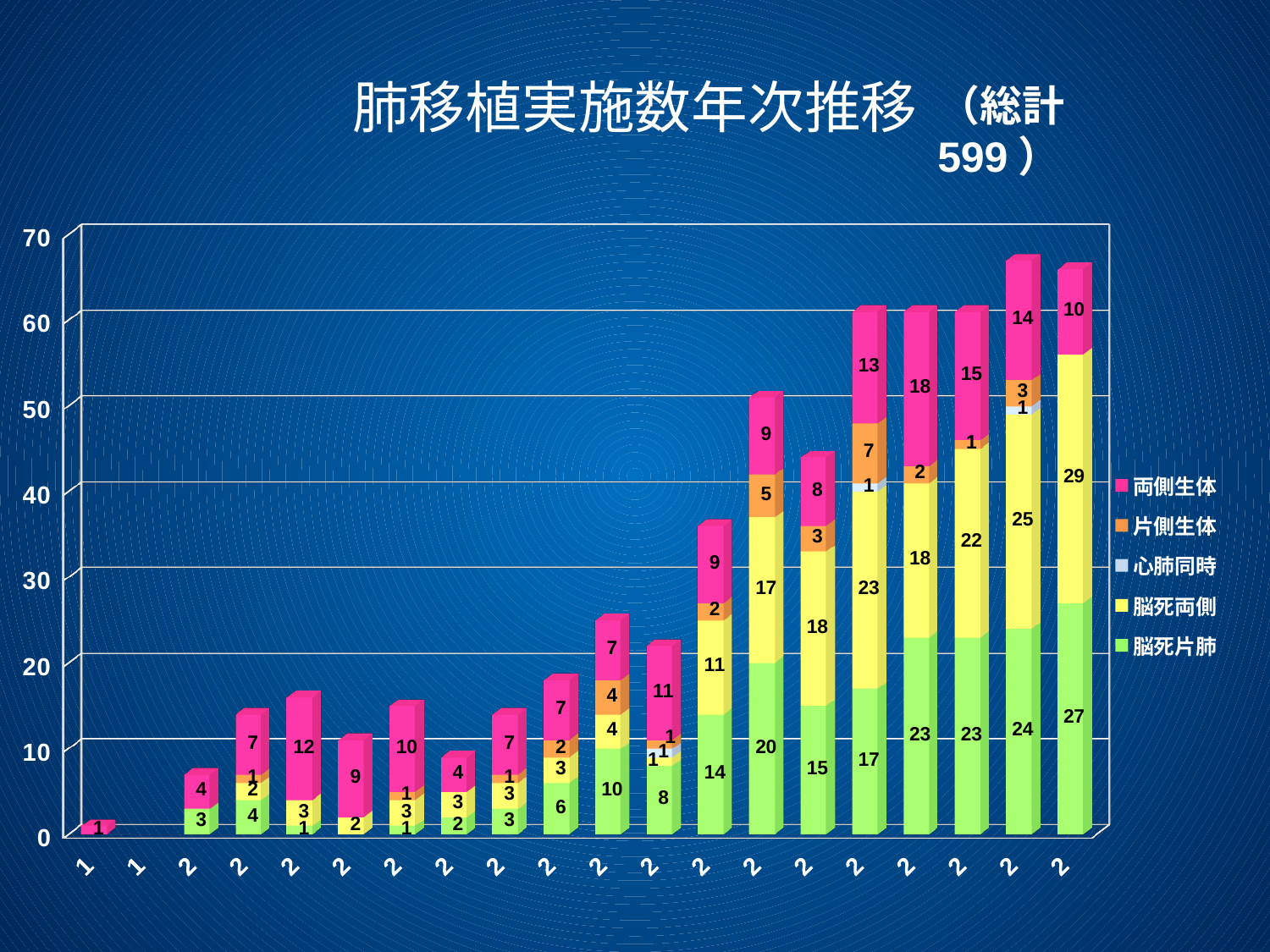
What is the 脳死両側 value in the rightmost bar? 29 In the rightmost bar, what is the difference between the 脳死両側 value and the 両側生体 value? 19 How many series does the legend list? 5 What total (総計) is given in the chart title? 599 What is the 脳死片肺 value in the rightmost bar? 27 In the rightmost bar, which is larger: 脳死両側 or 脳死片肺? 脳死両側 What is the total of the second bar from the right? 67 What is the 両側生体 value in the rightmost bar? 10 What kind of chart is shown on the slide? bar chart Is the total of the rightmost bar greater or less than 60? greater How many categories are shown along the x axis? 20 What is the total of the rightmost stacked bar? 66